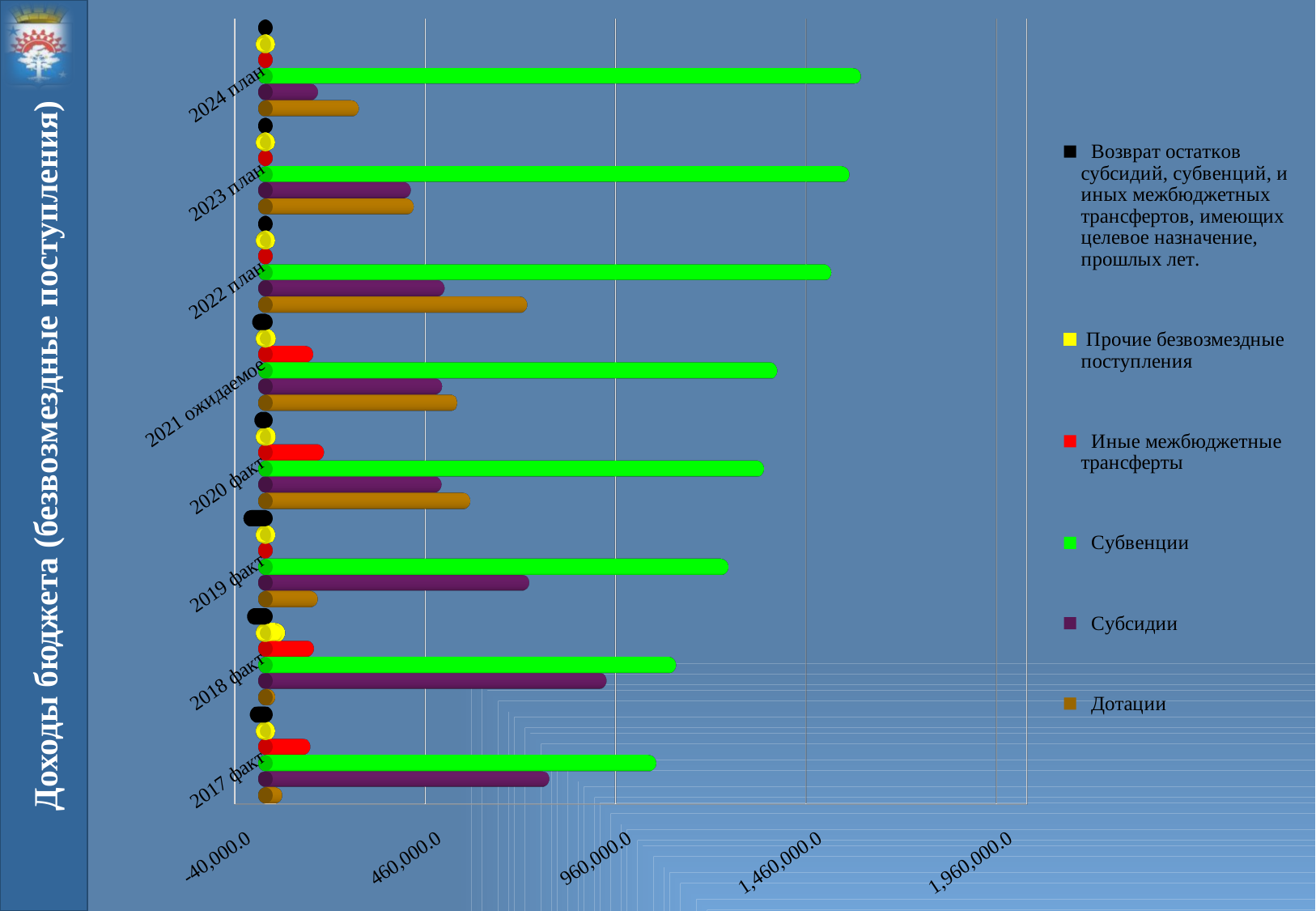
Which is larger: Субвенции in 2022 план or Субвенции in 2019 факт? 2022 план Which category has the highest value for Субсидии? 2018 факт Which category has the highest value for Дотации? 2022 план What colour represents Субвенции in the legend? Green How many categories (years) are shown on the chart? 8 Is the value for Субсидии in 2024 план greater or less than 460,000.0? less Do the values for Субвенции rise or fall from 2017 факт to 2024 план? Rise What kind of chart is shown on the slide? Bar chart Is the value for Субвенции in 2024 план greater or less than 1,460,000.0? greater How many series does the legend list? 6 Which category has the lowest value for Субвенции? 2017 факт Which category has the highest value for Субвенции? 2024 план